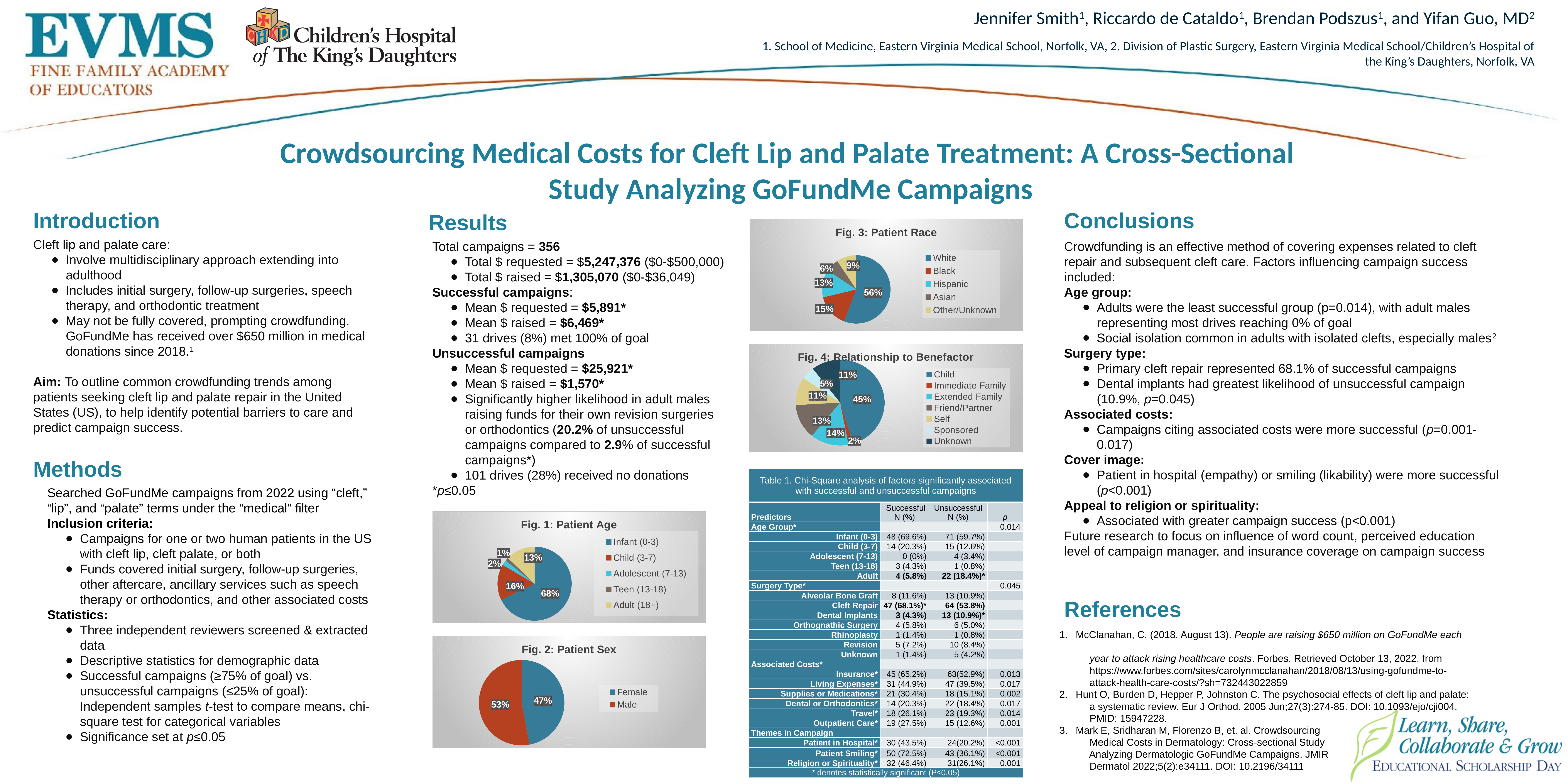
In Fig. 1: Patient Age, how many age categories does the legend list? 5 In Fig. 3: Patient Race, which category has the largest share? White In Fig. 1: Patient Age, which age group has the smallest share? Teen (13-18) In Fig. 2: Patient Sex, which is larger, the Female share or the Male share? Male In Fig. 4: Relationship to Benefactor, how many categories does the legend list? 7 What kind of chart is Fig. 3: Patient Race? Pie chart In Fig. 2: Patient Sex, what share of patients are Male? 53% In Fig. 4: Relationship to Benefactor, what share is Extended Family? 14% In Fig. 3: Patient Race, what share of patients are Black? 15% In Fig. 3: Patient Race, what is the difference between the White share and the Hispanic share? 43% In Fig. 4: Relationship to Benefactor, which category has the smallest share? Immediate Family In Fig. 1: Patient Age, what share of patients are Infant (0-3)? 68%